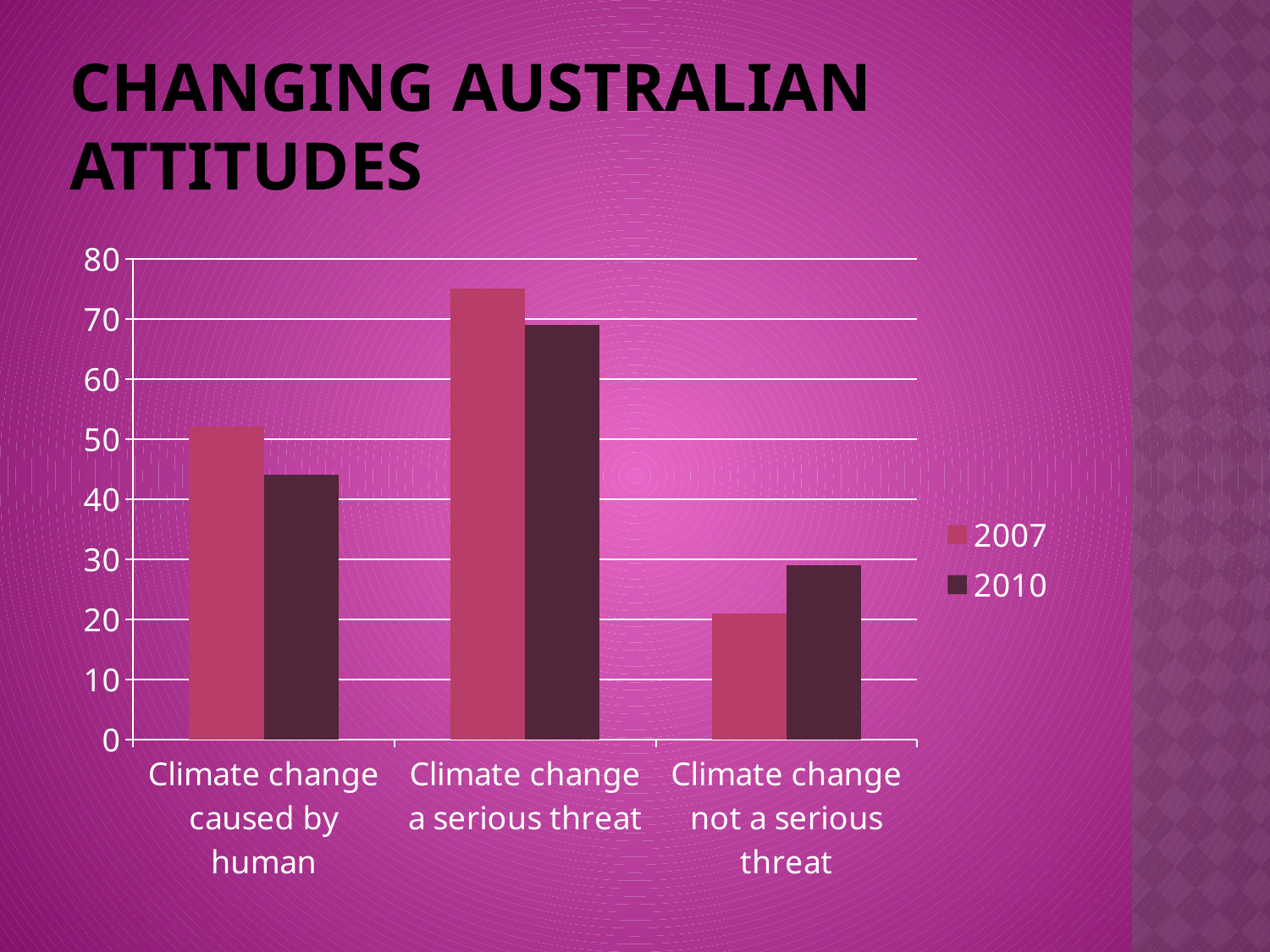
Is the 2007 value for 'Climate change not a serious threat' greater or less than 30? less For 'Climate change caused by human', which series has the larger value, 2007 or 2010? 2007 What is the title of the slide containing the chart? Changing Australian Attitudes Which category has the highest value for the 2007 series? Climate change a serious threat Is the 2010 value for 'Climate change caused by human' greater or less than 50? less What are the two series named in the legend? 2007 and 2010 Which category has the lowest value for the 2010 series? Climate change not a serious threat How many categories are shown on the x axis? 3 Is the 2007 value for 'Climate change a serious threat' greater or less than 70? greater For 'Climate change not a serious threat', which series has the larger value, 2007 or 2010? 2010 What kind of chart is shown on the slide? bar chart How many series does the legend list? 2